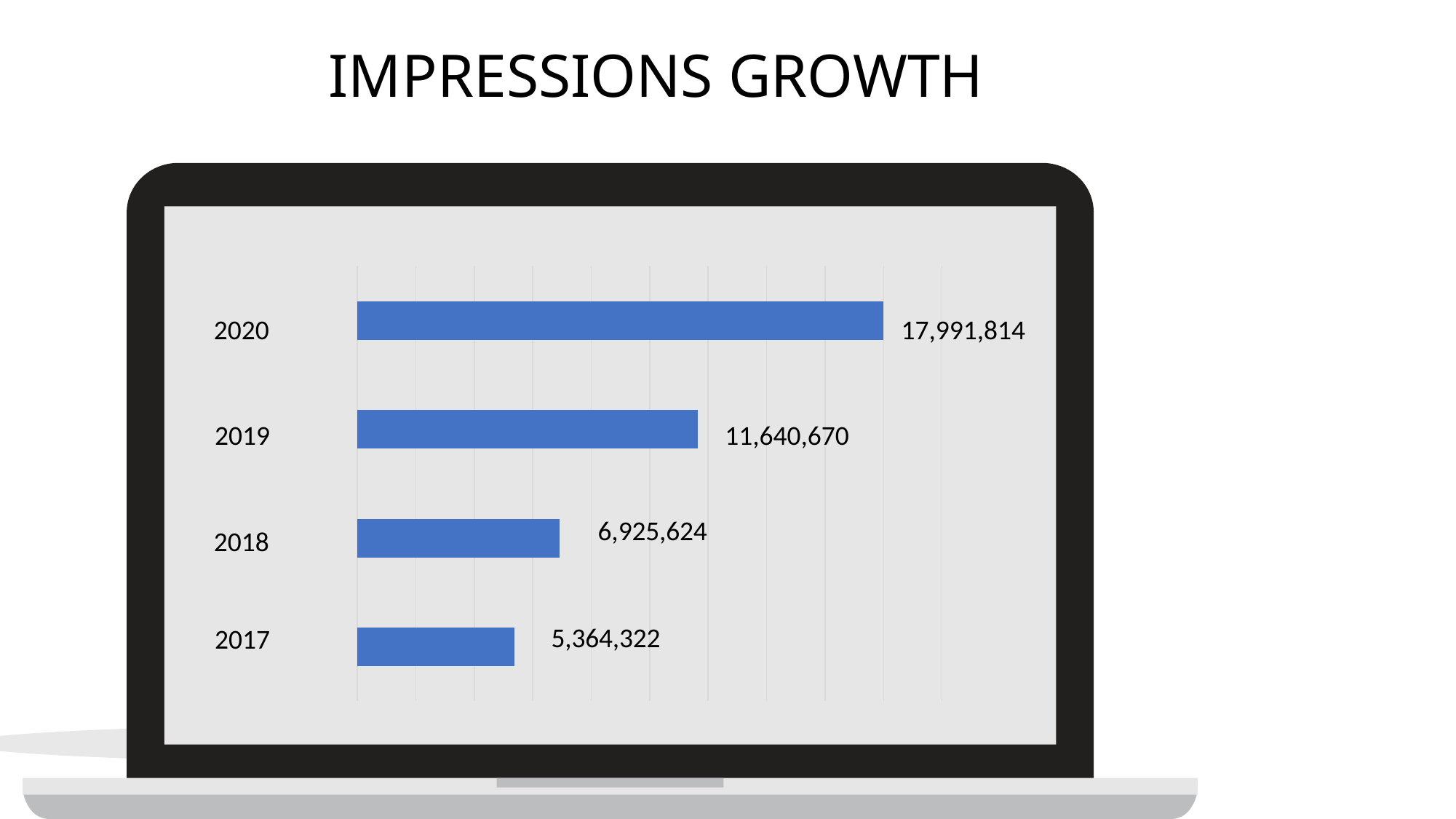
Which year has the highest value? 2020 Do the values rise or fall from 2017 to 2020? Rise What is the value shown for 2020? 17,991,814 What is the value shown for 2017? 5,364,322 What is the value shown for 2018? 6,925,624 What kind of chart is shown on the slide? Bar chart How many years are shown in the chart? 4 What is the difference between the values for 2018 and 2017? 1,561,302 Which is larger, the value for 2019 or the value for 2018? 2019 What is the value shown for 2019? 11,640,670 Which year has the lowest value? 2017 What is the difference between the values for 2020 and 2019? 6,351,144